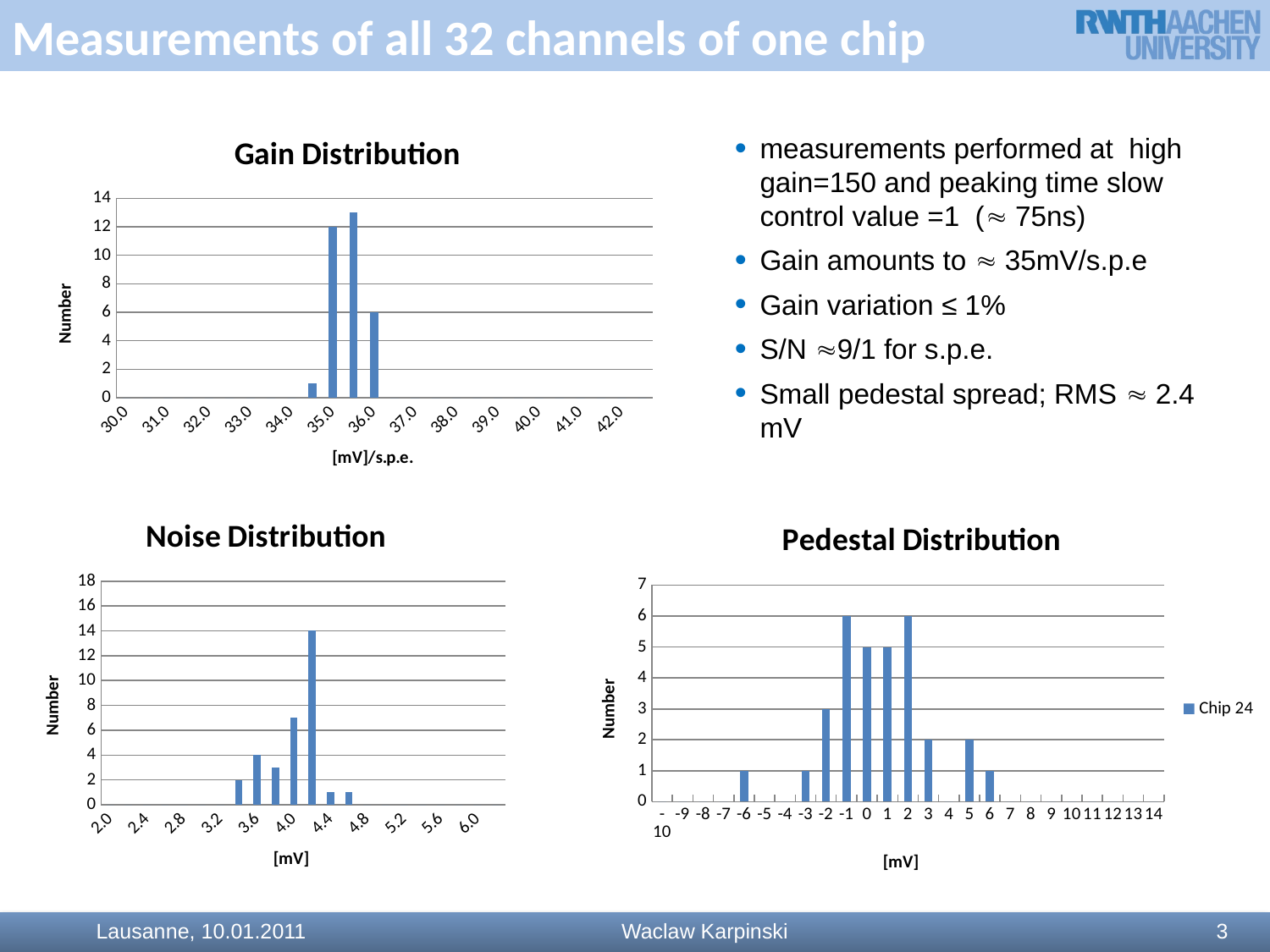
In the Noise Distribution chart, is the value of the bar at 4.0 mV greater or less than 6? greater How many bars are plotted in the Gain Distribution chart? 4 In the Noise Distribution chart, what is the height of the tallest bar? 14 What is the label of the y-axis on the Gain Distribution chart? Number What type of chart is the Gain Distribution chart? bar chart In the Pedestal Distribution chart, which bar is taller: the one at -2 mV or the one at 3 mV? -2 mV How many bars are plotted in the Noise Distribution chart? 7 In the Noise Distribution chart, what is the value of the bar at 3.6 mV? 4 In the Pedestal Distribution chart, what is the value of the bar at -1 mV? 6 In the Gain Distribution chart, is the tallest bar greater or less than 12? greater In the Pedestal Distribution chart, what is the difference between the bar at -1 mV and the bar at 3 mV? 4 In the Pedestal Distribution chart, what is the value of the bar at 3 mV? 2